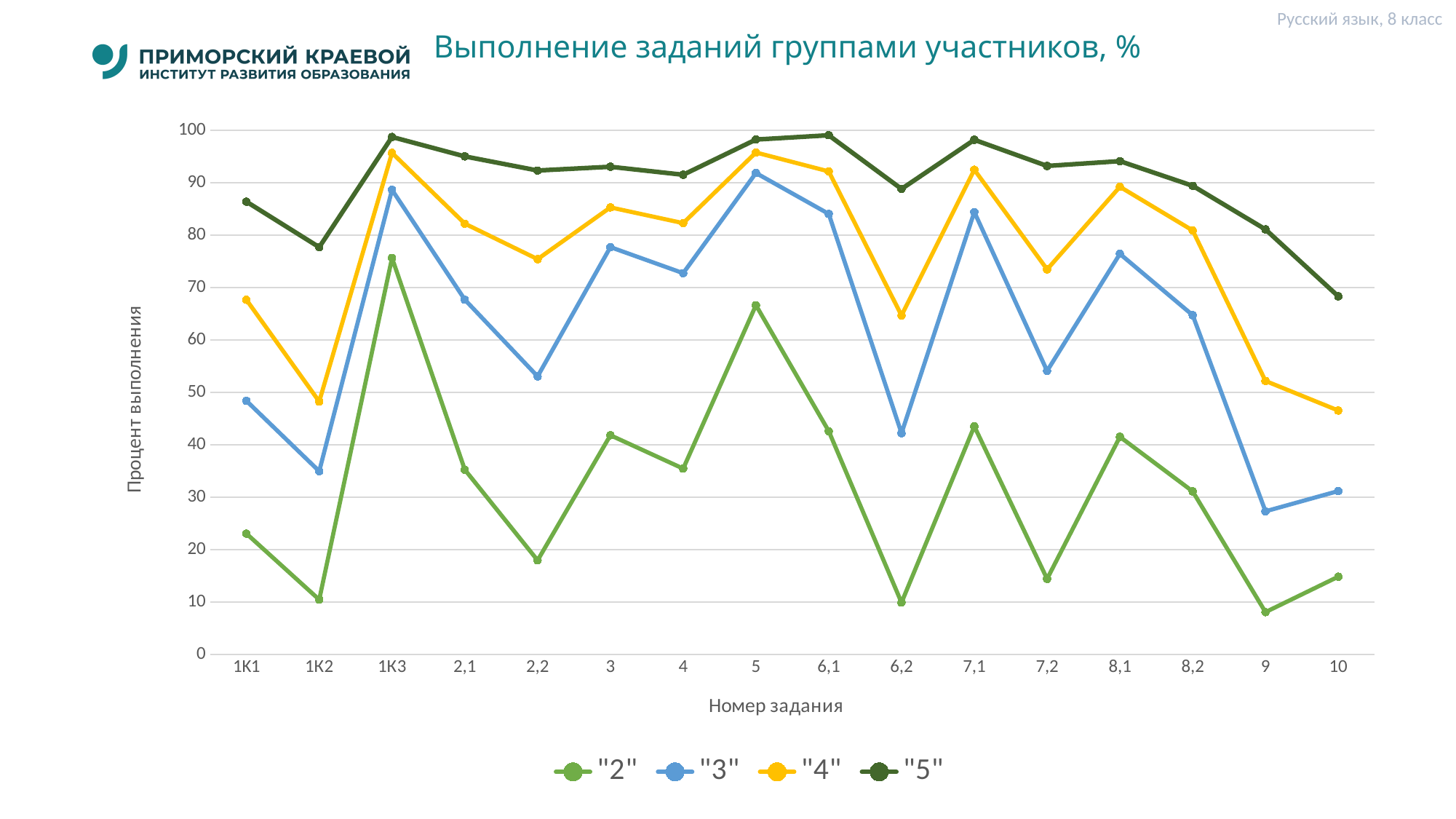
What kind of chart is shown on the slide? line chart Does the series "5" rise or fall from task 8,1 to task 10? fall How many task numbers are shown along the x axis? 16 For which task number does the series "3" reach its highest value? 5 Is the value of series "4" for task 6,2 greater or less than 60? greater What is the title of the chart? Выполнение заданий группами участников, % For task 10, which series has the larger value: "3" or "2"? "3" How many series does the legend list? 4 Is the value of series "2" for task 1К1 greater or less than 30? less For which task number does the series "3" reach its lowest value? 9 Is the value of series "5" for task 1К2 greater or less than 80? less For which task number does the series "2" reach its highest value? 1К3